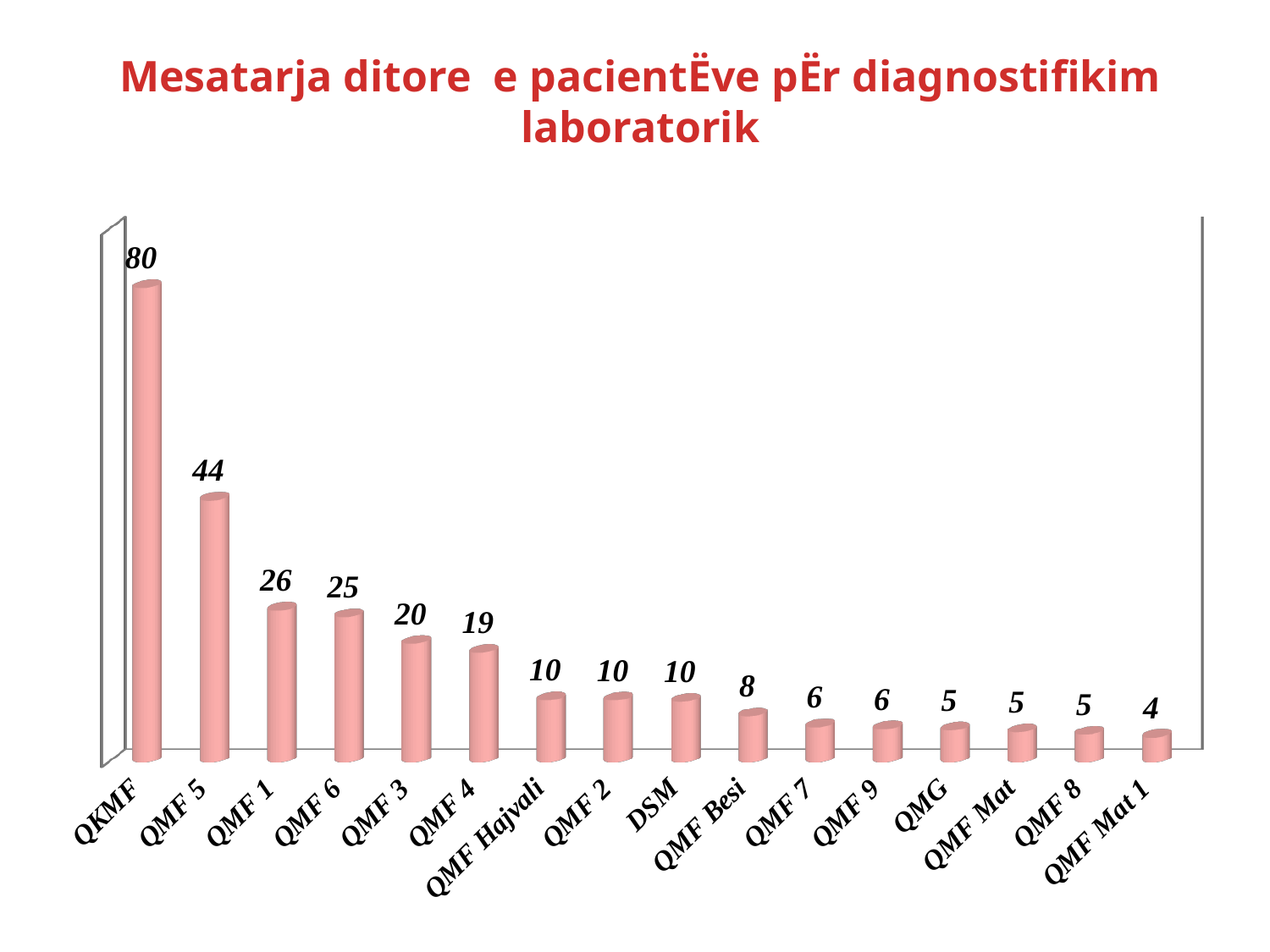
What is the title of the chart? Mesatarja ditore e pacientËve pËr diagnostifikim laboratorik What is the value for QKMF? 80 Which category has the highest value? QKMF What is the value for QMF Besi? 8 What kind of chart is shown on the slide? bar chart What is the value for QMF Hajvali? 10 Which is larger, the value for QMF 3 or the value for QMF 4? QMF 3 What is the difference between the values for QKMF and QMF 5? 36 Which category has the lowest value? QMF Mat 1 Do the values rise or fall from left to right along the x axis? fall How many categories are shown on the x axis? 16 What is the difference between the values for QMF 1 and QMF 6? 1